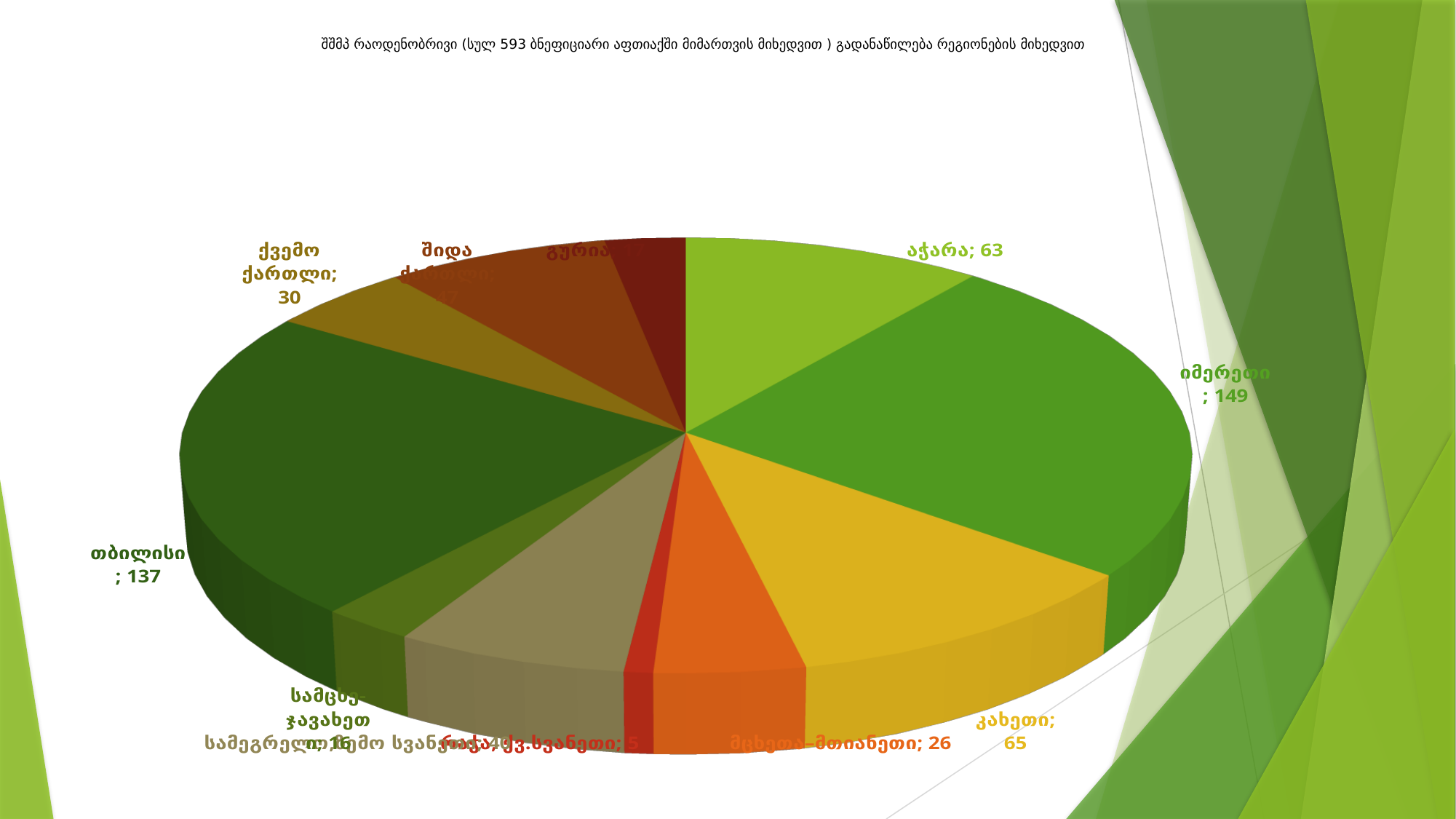
What is the value for აჭარა? 63 Which is larger, the value for კახეთი or the value for აჭარა? კახეთი What is the value for თბილისი? 137 What kind of chart is shown on the slide? pie chart According to the chart title, how many beneficiaries are there in total? 593 Which region has the largest slice of the pie? იმერეთი What is the value for იმერეთი? 149 What is the value for მცხეთა-მთიანეთი? 26 What is the difference between the values for იმერეთი and თბილისი? 12 What is the value for ქვემო ქართლი? 30 What is the value for კახეთი? 65 How many slices does the pie chart have? 11